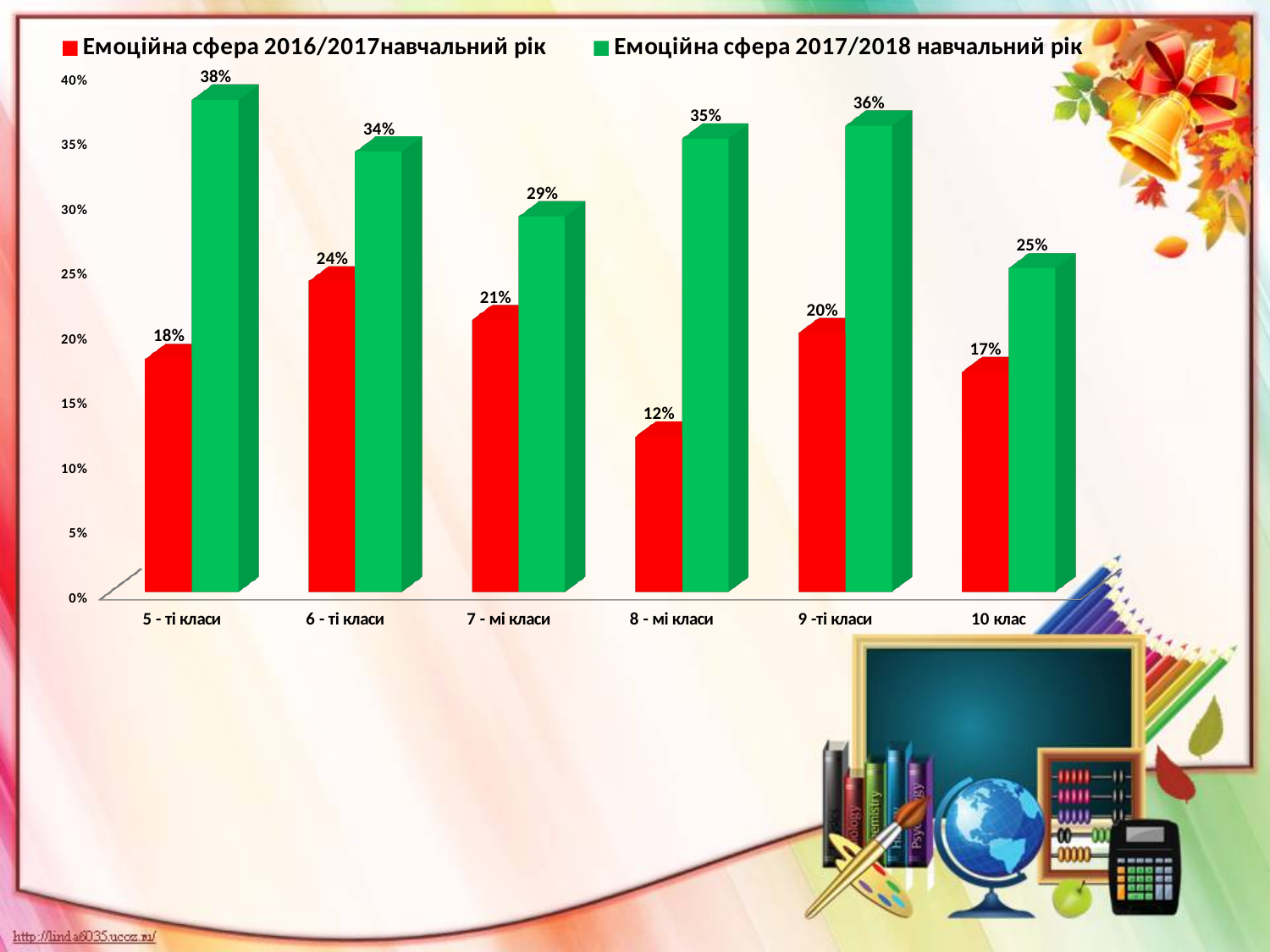
What is the value for 9 -ті класи in the Емоційна сфера 2017/2018 навчальний рік series? 36% How many series does the legend list? 2 What is the difference between the 2017/2018 and 2016/2017 values for 6 - ті класи? 10% What is the value for 8 - мі класи in the Емоційна сфера 2016/2017навчальний рік series? 12% Which category has the highest value in the Емоційна сфера 2017/2018 навчальний рік series? 5 - ті класи Which is larger: the 2016/2017 value for 6 - ті класи or the 2016/2017 value for 7 - мі класи? 6 - ті класи What colour are the bars for the Емоційна сфера 2017/2018 навчальний рік series? Green Which category has the lowest value in the Емоційна сфера 2016/2017навчальний рік series? 8 - мі класи How many categories are shown on the x axis? 6 What is the value for 10 клас in the Емоційна сфера 2016/2017навчальний рік series? 17% What kind of chart is shown on the slide? Bar chart What is the difference between the 2017/2018 and 2016/2017 values for 8 - мі класи? 23%